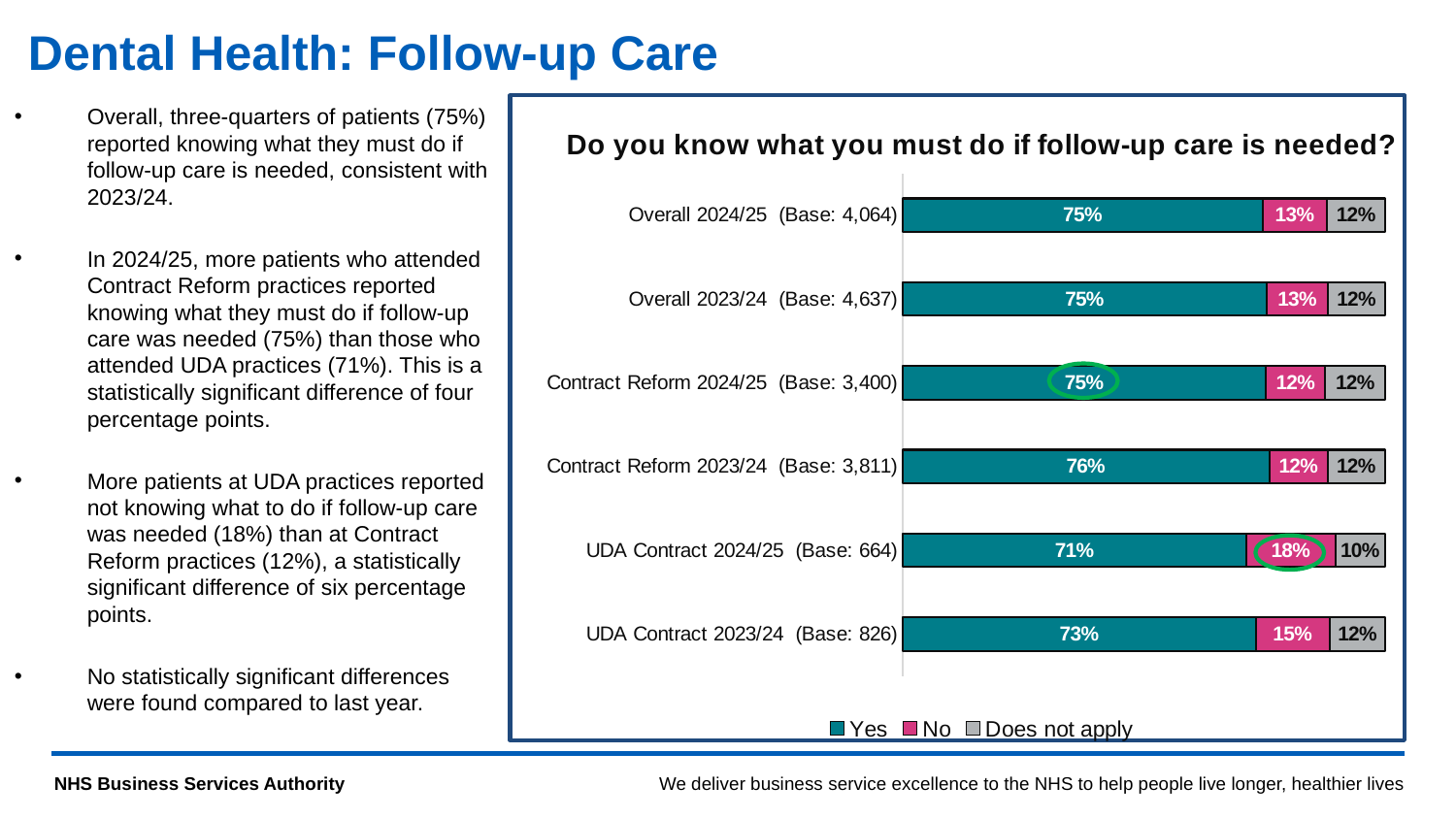
What is the title of the chart? Do you know what you must do if follow-up care is needed? Which category has the lowest Yes percentage? UDA Contract 2024/25 Which category has the highest Yes percentage? Contract Reform 2023/24 What kind of chart is shown? Stacked bar chart How many series does the legend list? 3 Which has a larger No percentage, UDA Contract 2024/25 or Contract Reform 2024/25? UDA Contract 2024/25 What percentage of Overall 2024/25 respondents answered Yes? 75% What percentage of UDA Contract 2024/25 respondents answered No? 18% What is the base (number of respondents) for UDA Contract 2023/24? 826 What is the difference in the Yes percentage between Contract Reform 2024/25 and UDA Contract 2024/25? 4 percentage points What is the Does not apply value for UDA Contract 2024/25? 10% How many categories are shown on the chart? 6